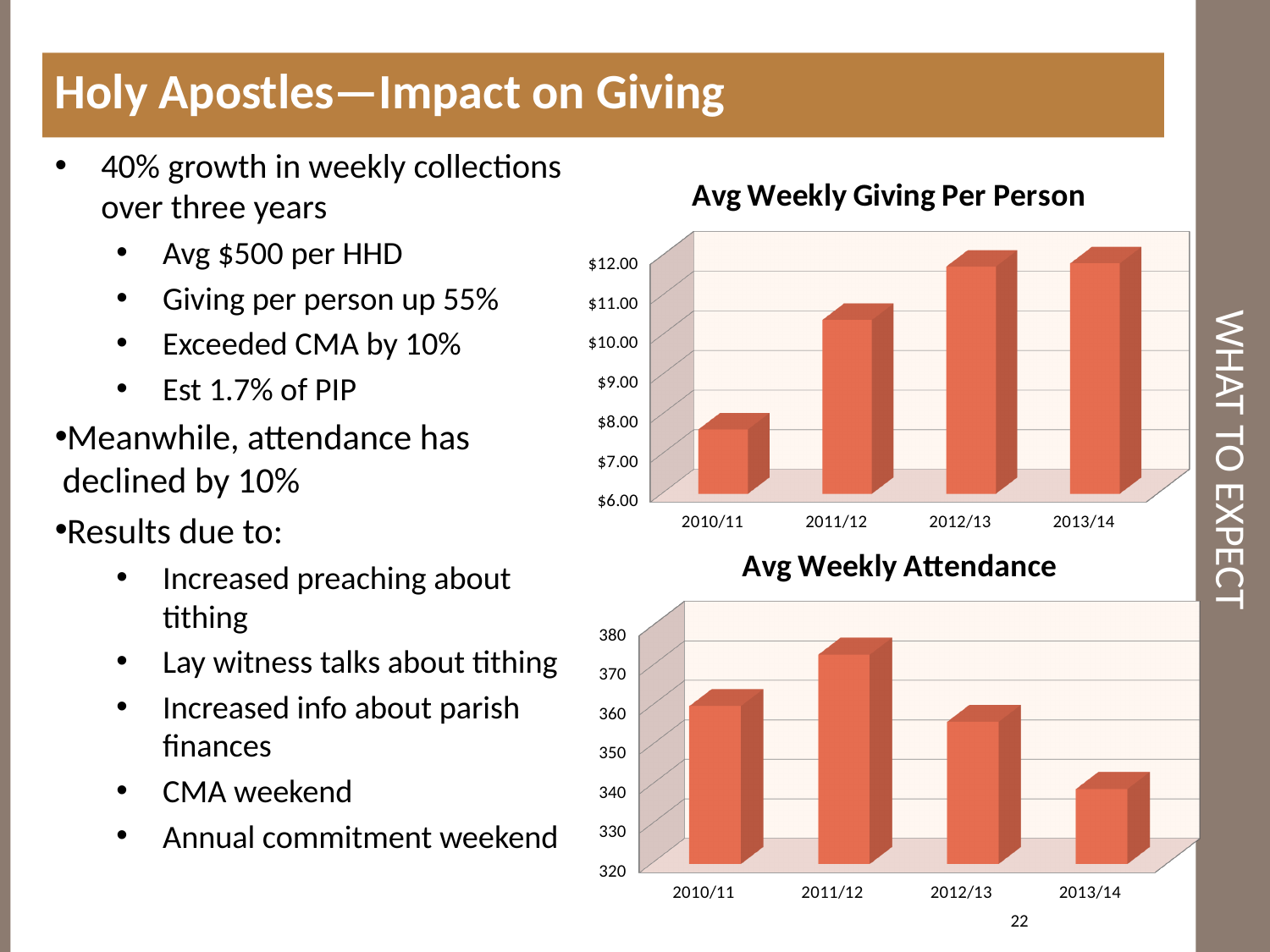
In the 'Avg Weekly Giving Per Person' chart, is the value for 2011/12 greater or less than $10.00? greater In the 'Avg Weekly Attendance' chart, which year has the highest value? 2011/12 How many categories are shown on the x axis of the 'Avg Weekly Giving Per Person' chart? 4 In the 'Avg Weekly Attendance' chart, which is larger, the value for 2010/11 or the value for 2012/13? 2010/11 What is the title of the lower chart on the slide? Avg Weekly Attendance What kind of chart is the 'Avg Weekly Giving Per Person' chart? Bar chart In the 'Avg Weekly Giving Per Person' chart, do the values generally rise or fall from 2010/11 to 2013/14? rise In the 'Avg Weekly Attendance' chart, which year has the lowest value? 2013/14 In the 'Avg Weekly Giving Per Person' chart, is the value for 2012/13 greater or less than $11.00? greater In the 'Avg Weekly Giving Per Person' chart, is the value for 2010/11 greater or less than $8.00? less In the 'Avg Weekly Giving Per Person' chart, which year has the lowest value? 2010/11